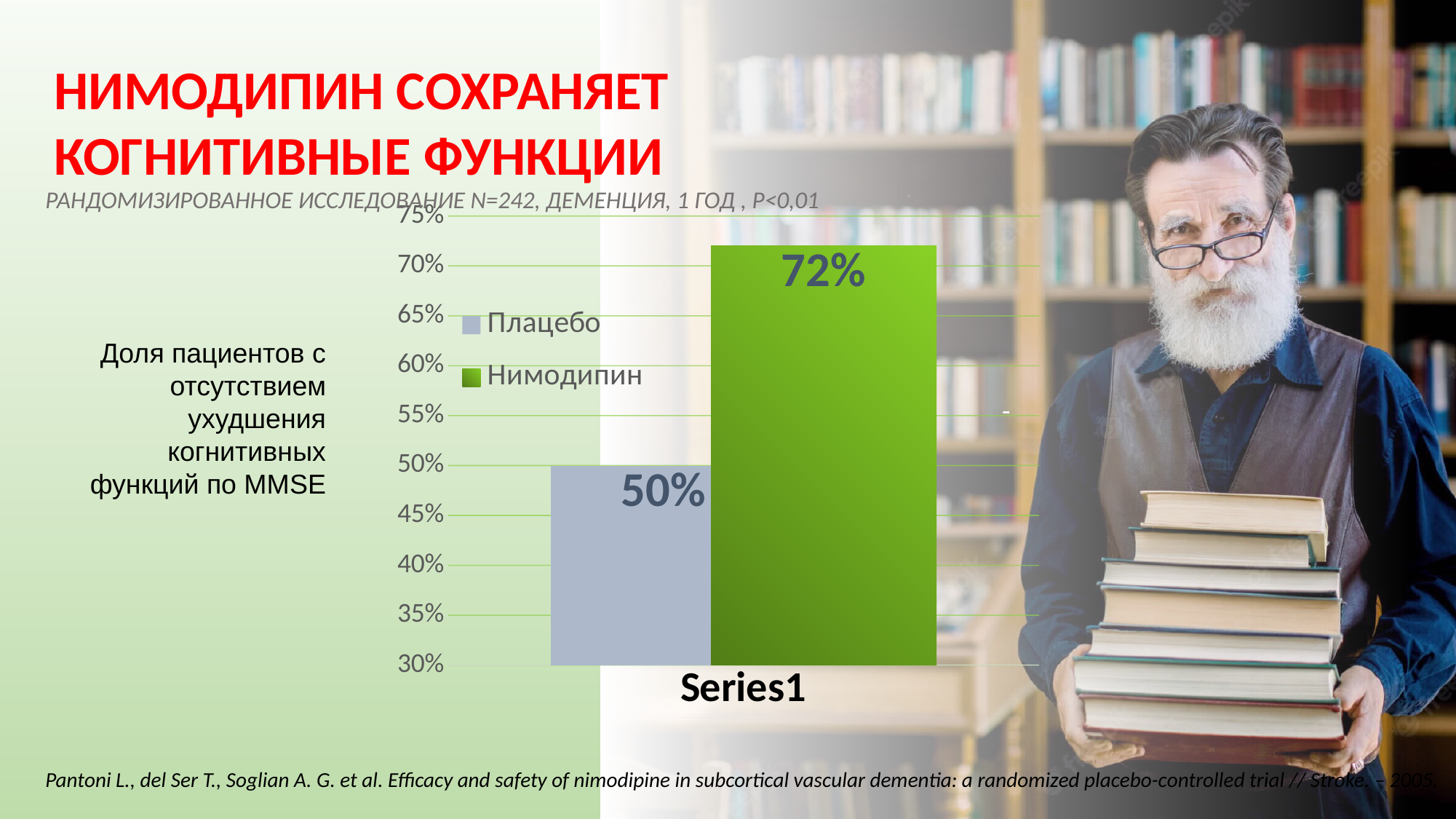
Which series has the lowest value in the chart? Плацебо What value is shown for Нимодипин? 72% Which series has the higher value, Плацебо or Нимодипин? Нимодипин What colour is the bar for Нимодипин? Green What value is shown for Плацебо? 50% How many bars are plotted in the chart? 2 How many series does the legend list? 2 What is the difference between the Нимодипин and Плацебо values? 22% Is the value for Нимодипин greater or less than 70%? greater Is the value for Плацебо greater or less than 55%? less What kind of chart is shown on the slide? Bar chart What is the label shown on the category axis below the bars? Series1